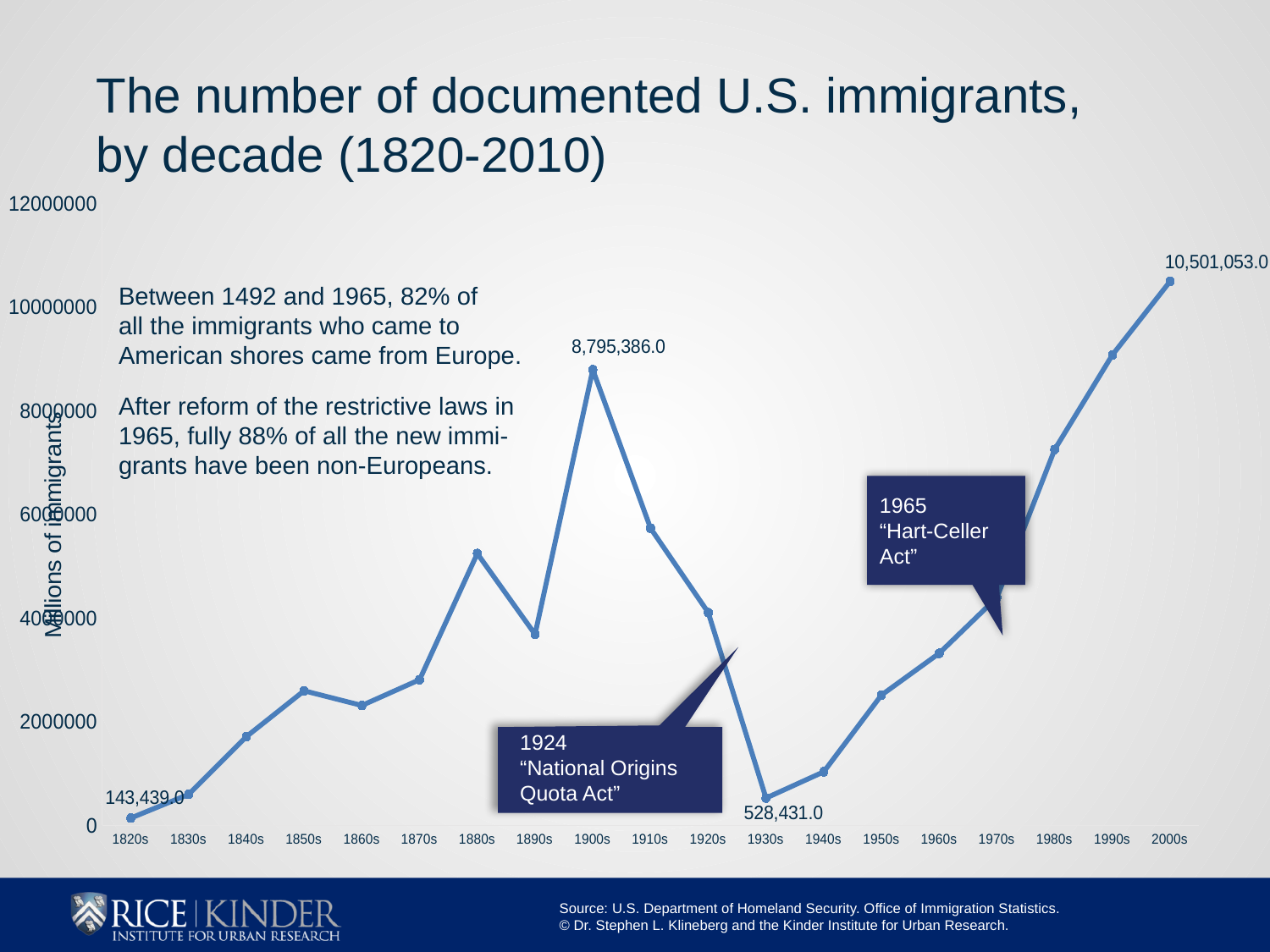
How many decades are plotted on the x axis? 19 What is the difference between the number of immigrants in the 1900s and in the 1930s? 8,266,955.0 Is the value for the 1940s greater or less than 2000000? less Is the value for the 1880s greater or less than 4000000? greater What kind of chart is shown on the slide? line chart What is the difference between the number of immigrants in the 2000s and in the 1900s? 1,705,667.0 What is the number of documented immigrants for the 1930s? 528,431.0 Do the values rise or fall from the 1930s to the 2000s? rise What is the number of documented immigrants for the 1900s? 8,795,386.0 What is the number of documented immigrants for the 2000s? 10,501,053.0 Which decade has the lowest number of documented immigrants? 1820s Which decade has the highest number of documented immigrants? 2000s